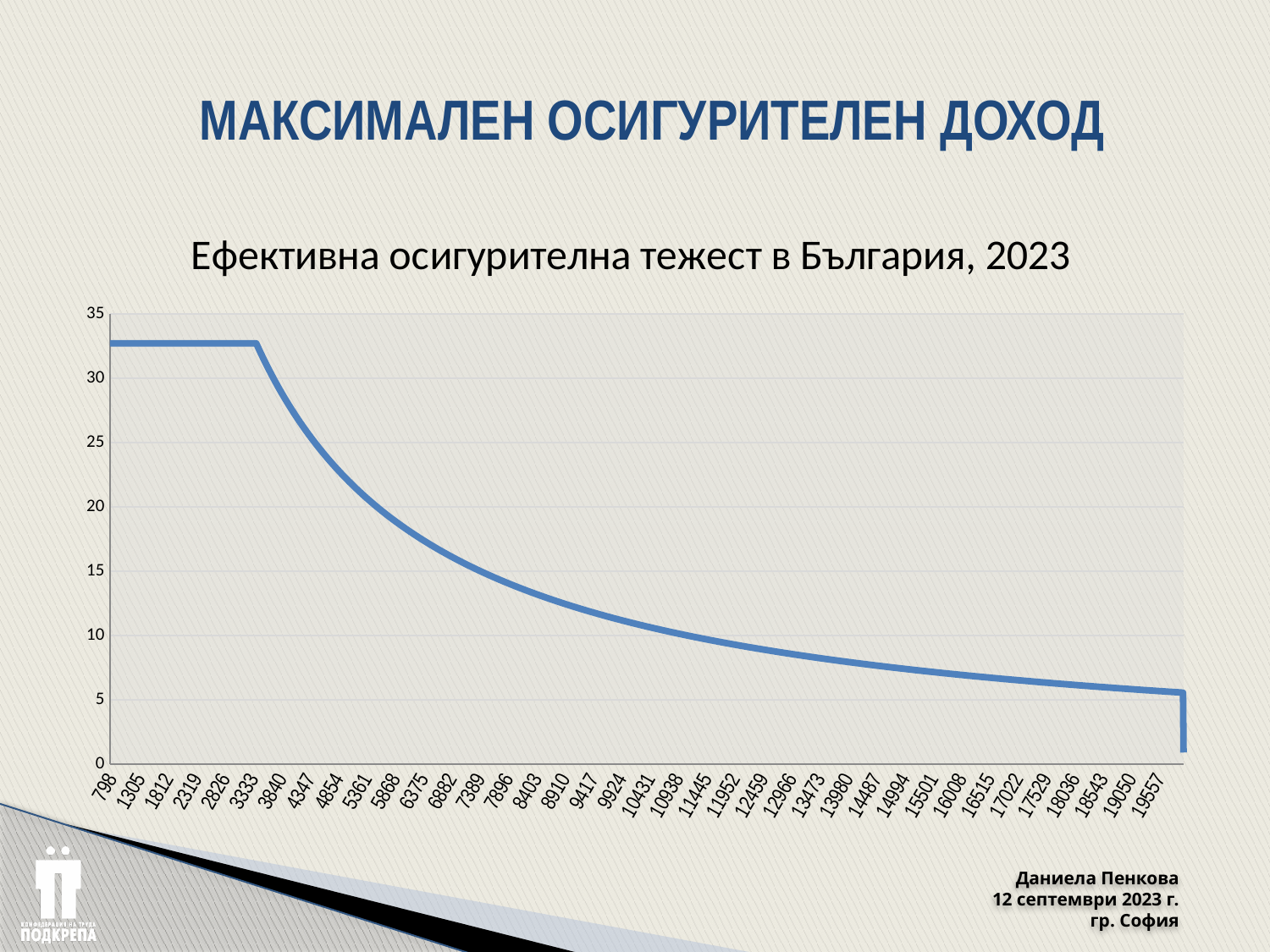
Is the value for 7896 greater or less than 15? less What kind of chart is shown on the slide? line chart What is the highest tick value shown on the y axis? 35 Is the value for 19557 greater or less than 10? less Is the value for 798 greater or less than 30? greater What is the title of the chart? Ефективна осигурителна тежест в България, 2023 Do the values generally rise or fall as you move from left to right along the x axis? fall Which has the larger value, 2826 or 12459? 2826